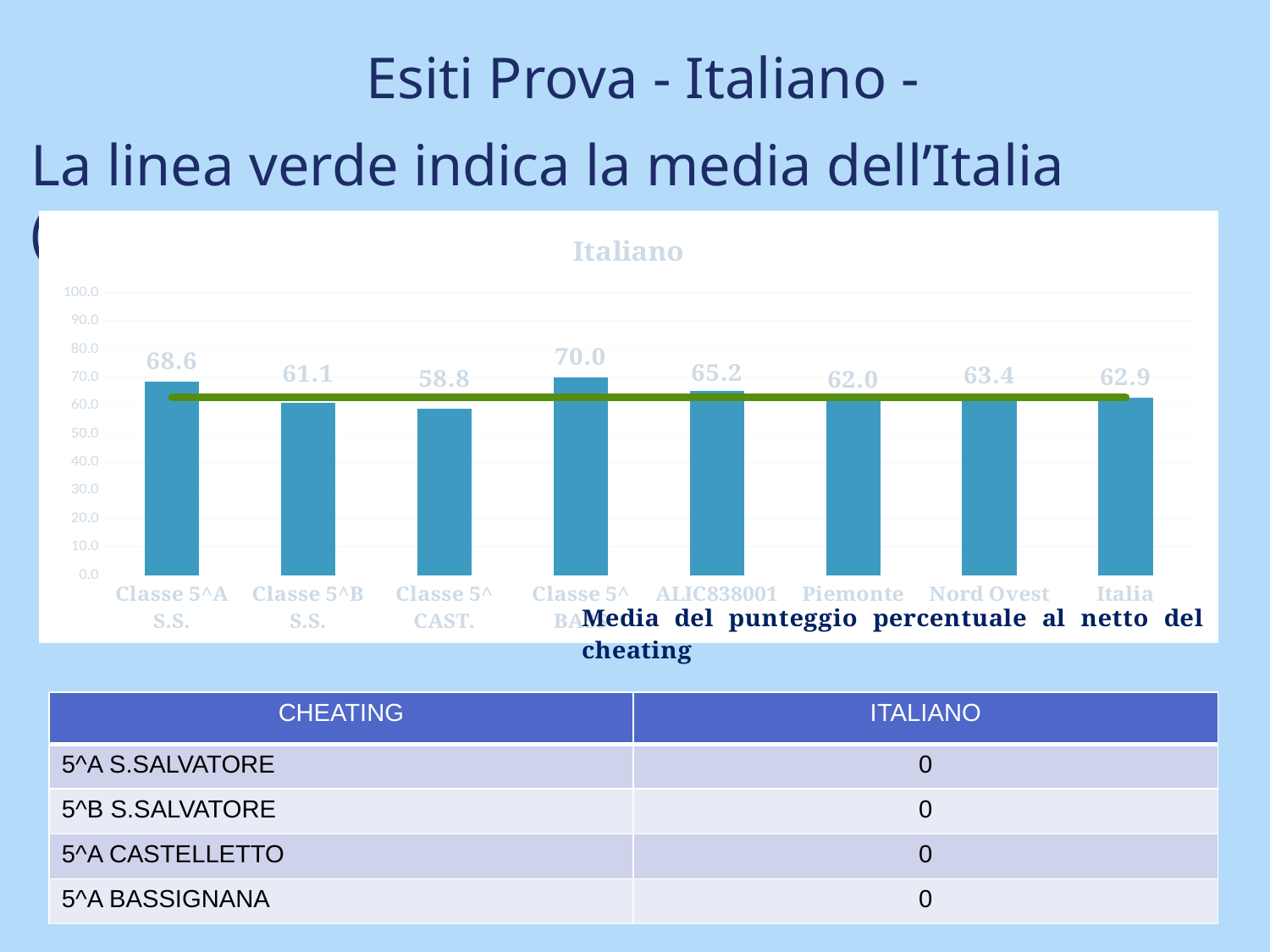
How many bars are shown in the Italiano chart? 8 Is the value for Classe 5^ CAST. greater or less than 60.0 in the Italiano chart? less What is the value for Classe 5^A S.S. in the Italiano chart? 68.6 Which is larger in the Italiano chart, the value for Nord Ovest or the value for Piemonte? Nord Ovest What kind of chart is the Italiano chart? combination bar and line chart What is the value for Piemonte in the Italiano chart? 62.0 What is the highest value shown in the Italiano chart? 70.0 What is the value for ALIC838001 in the Italiano chart? 65.2 What is the value for Italia in the Italiano chart? 62.9 What is the difference between the values for Classe 5^A S.S. and Classe 5^B S.S. in the Italiano chart? 7.5 Which category has the lowest value in the Italiano chart? Classe 5^ CAST. What is the value for Nord Ovest in the Italiano chart? 63.4